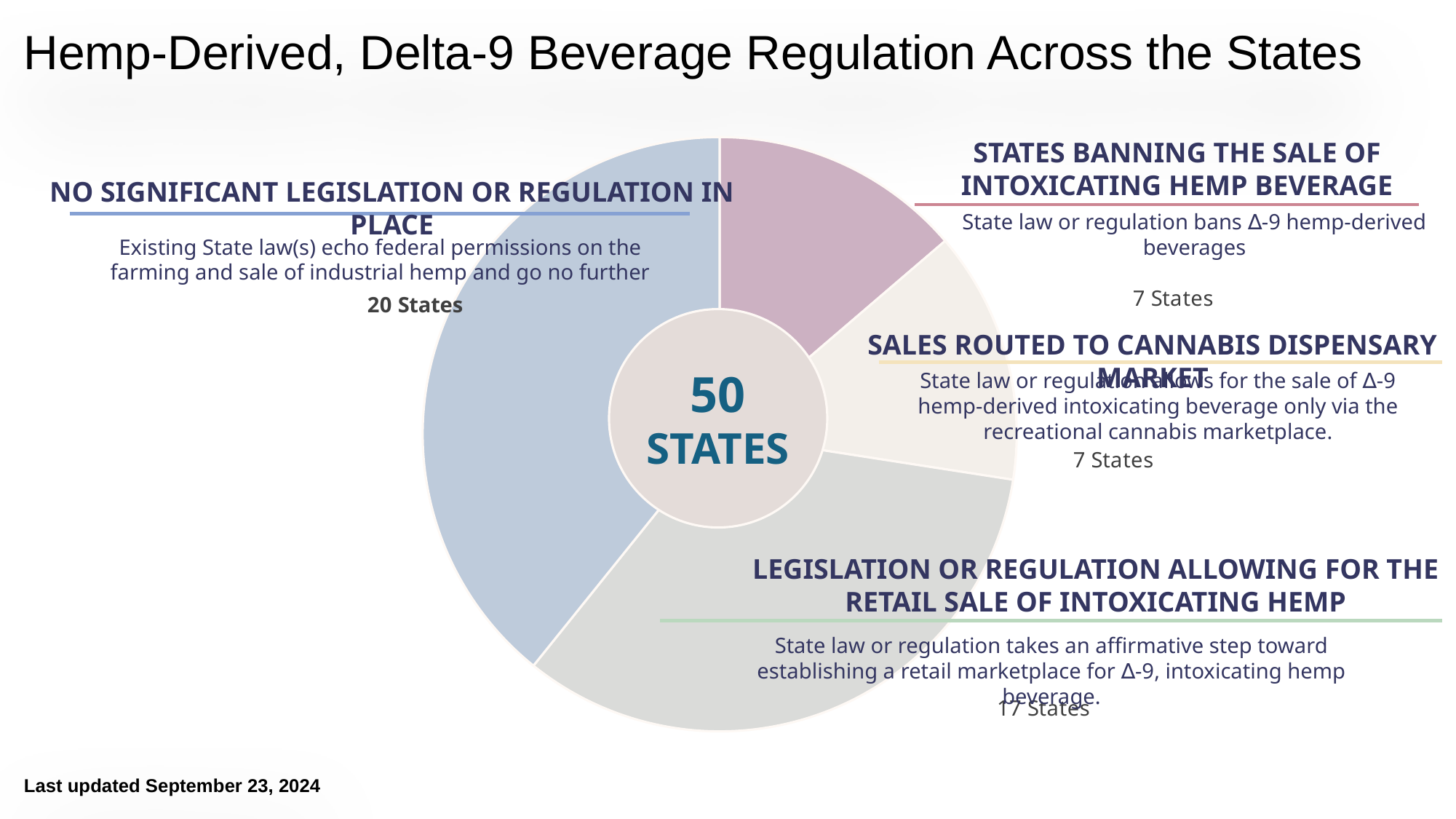
How many states have legislation or regulation allowing for the retail sale of intoxicating hemp? 17 States Which is larger: the number of states with no significant legislation or regulation, or the number allowing retail sale of intoxicating hemp? No significant legislation or regulation in place How many states route sales to the cannabis dispensary market? 7 States What is the title of the slide? Hemp-Derived, Delta-9 Beverage Regulation Across the States How many states have no significant legislation or regulation in place? 20 States What is the difference between the number of states allowing retail sale of intoxicating hemp and the number banning the sale of intoxicating hemp beverage? 10 How many more states have no significant legislation or regulation than allow the retail sale of intoxicating hemp? 3 How many states ban the sale of intoxicating hemp beverage? 7 States How many categories does the pie chart divide the states into? 4 What kind of chart is shown on the slide? pie chart What text appears in the centre of the pie chart? 50 STATES Which category accounts for the largest number of states? No significant legislation or regulation in place